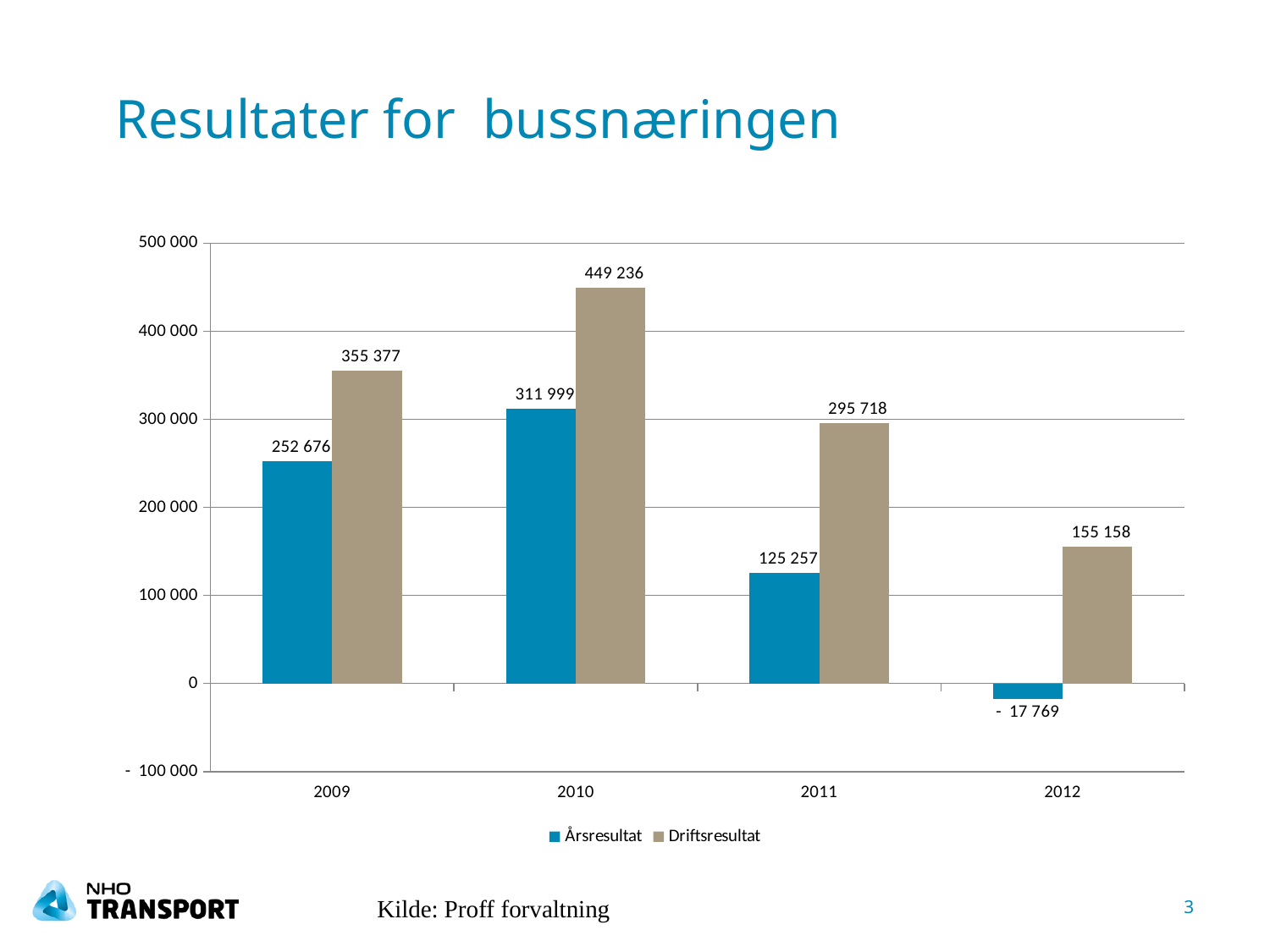
Does the Årsresultat series rise or fall from 2010 to 2012? Fall Which year has the highest Driftsresultat? 2010 How many series does the legend list? 2 What is the difference between Driftsresultat and Årsresultat in 2009? 102 701 Which is larger in 2011, Årsresultat or Driftsresultat? Driftsresultat Is the Driftsresultat value for 2011 greater or less than 200 000? greater What is the Årsresultat value for 2012? - 17 769 What kind of chart is shown on the slide? Bar chart What is the Driftsresultat value for 2012? 155 158 Which year has the lowest Årsresultat? 2012 How many years are shown on the x axis? 4 What is the Årsresultat value for 2010? 311 999